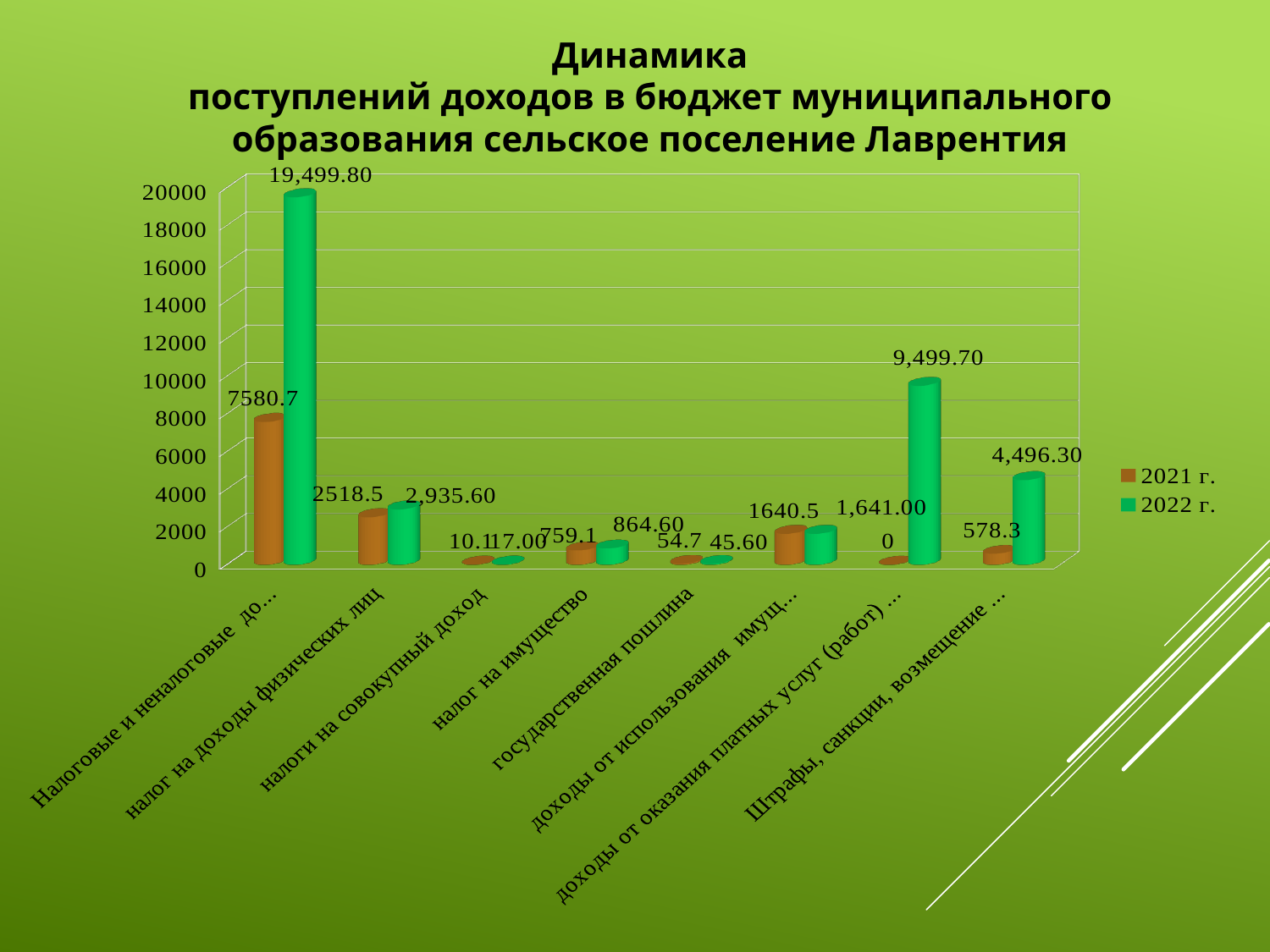
For налог на имущество, which series has the larger value, 2021 г. or 2022 г.? 2022 г. How many series does the legend list? 2 What is the 2021 г. value for the last category, Штрафы, санкции, возмещение ...? 578.3 For государственная пошлина, which series has the larger value, 2021 г. or 2022 г.? 2021 г. What is the difference between the 2022 г. and 2021 г. values for налог на имущество? 105.5 What is the 2021 г. value for государственная пошлина? 54.7 What kind of chart is shown on the slide? bar chart How many categories are shown on the x axis? 8 What is the 2022 г. value for налог на имущество? 864.60 By how much does the 2022 г. value for налог на доходы физических лиц exceed the 2021 г. value? 417.1 What is the 2021 г. value for налог на доходы физических лиц? 2518.5 What is the 2022 г. value for налог на доходы физических лиц? 2,935.60